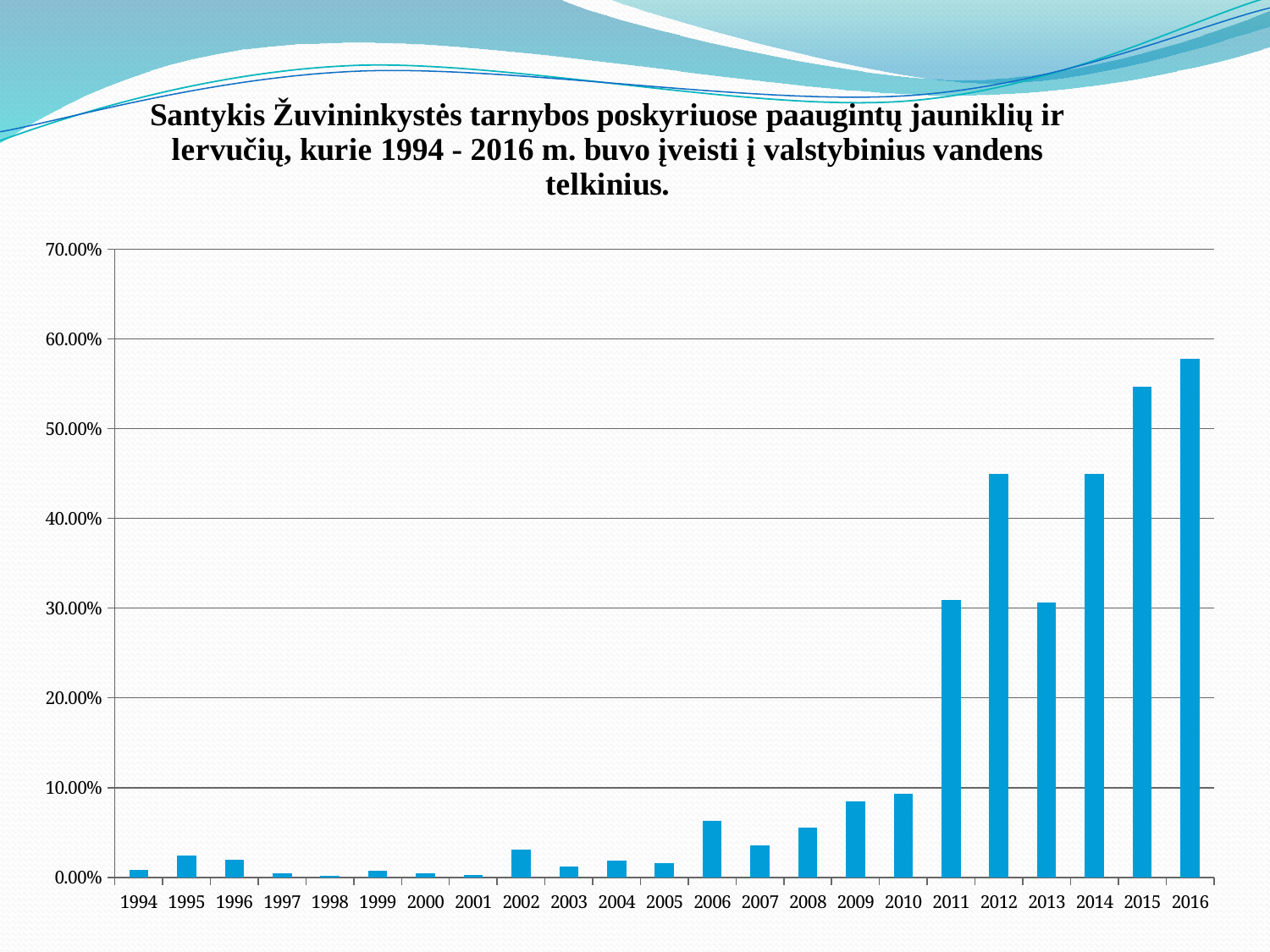
Is the value for 2016 greater or less than 50.00%? greater Which year has the larger value, 2010 or 2011? 2011 Which year has the highest value in the chart? 2016 Is the value for 2010 greater or less than 10.00%? less Is the value for 2011 greater or less than 20.00%? greater What is the highest value shown on the y axis of the chart? 70.00% What kind of chart is shown on the slide? bar chart How many years are shown on the x axis of the chart? 23 Do the values generally rise or fall from 1994 to 2016? rise Which year has the larger value, 2015 or 2016? 2016